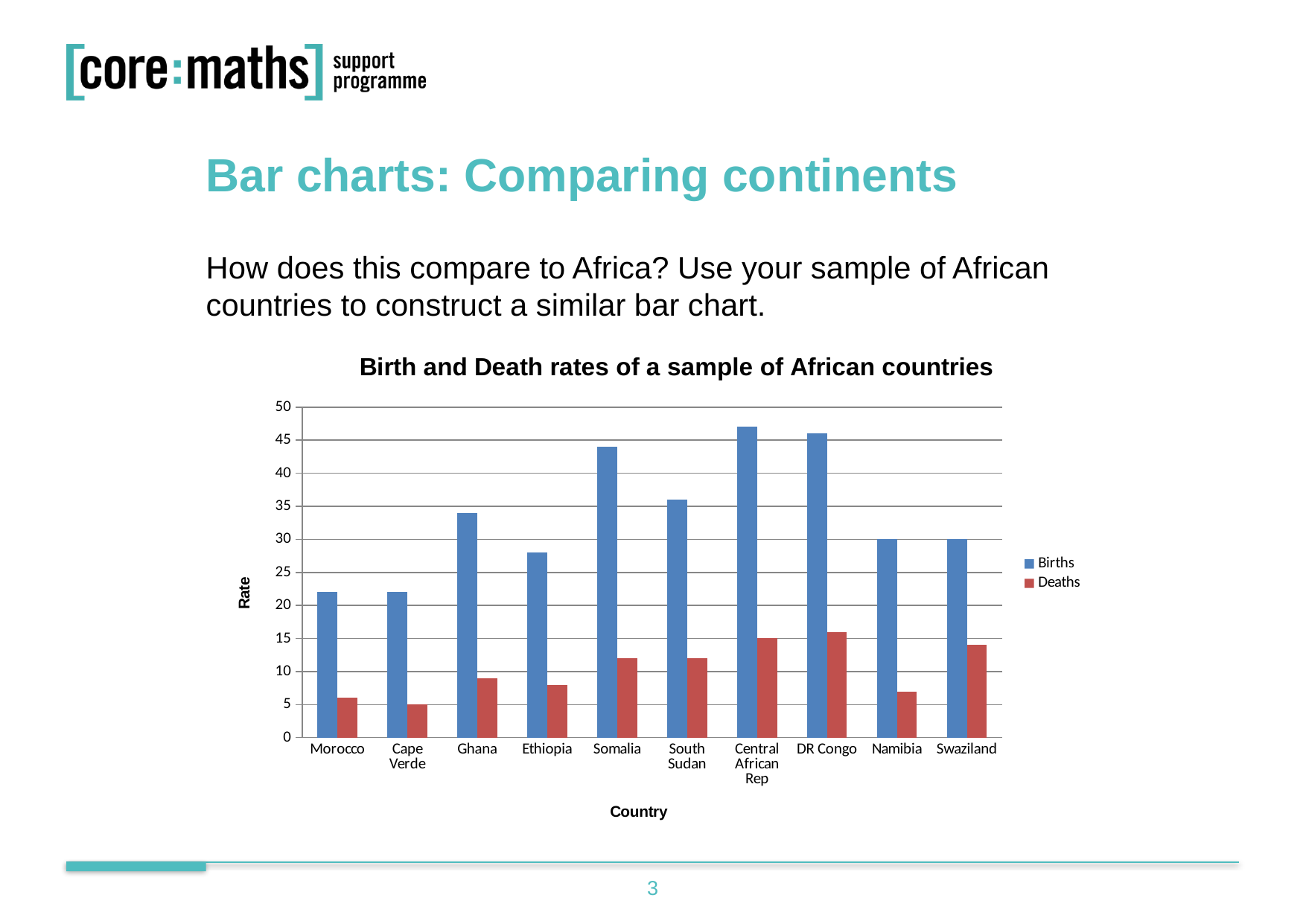
Is the Births value for Somalia greater or less than 40? greater Which is larger, the Births value for Somalia or the Births value for Ghana? Somalia How many series does the legend list? 2 Is the Births value for Ethiopia greater or less than 30? less What is the Births value for Namibia? 30 What is the title of the chart? Birth and Death rates of a sample of African countries Which colour represents Deaths in the legend? Red What is the Deaths value for Cape Verde? 5 How many countries are shown on the x axis? 10 Is the Deaths value for Ghana greater or less than 10? less What kind of chart is shown on the slide? Bar chart What is the Deaths value for Central African Rep? 15